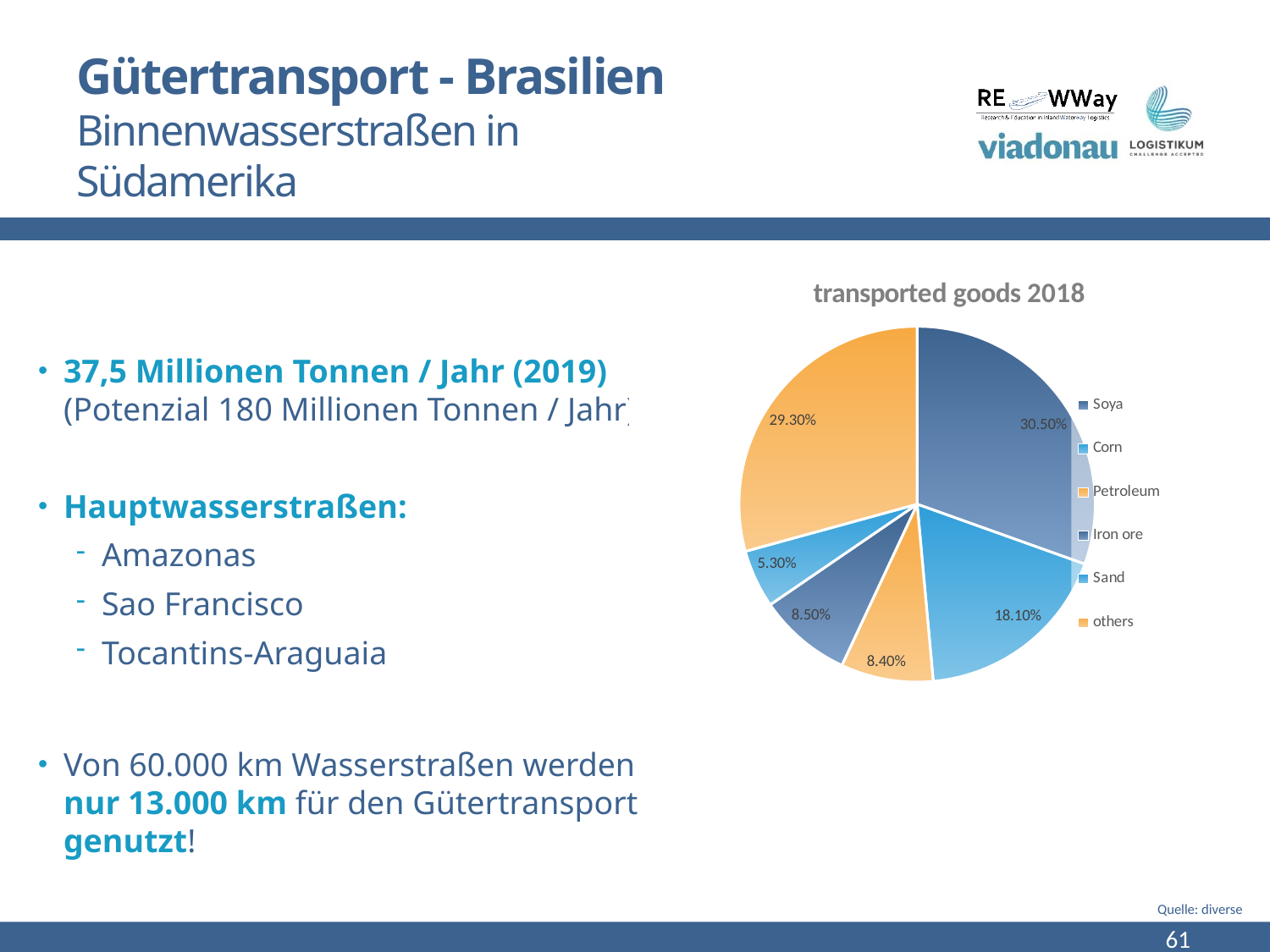
What is the difference between the shares of Soya and others? 1.20% What share of transported goods in 2018 is Iron ore? 8.50% Which has a larger share, Corn or others? others What share of transported goods in 2018 is Soya? 30.50% What share of transported goods in 2018 is Petroleum? 8.40% How many categories does the legend of the pie chart list? 6 What kind of chart is shown on the slide? pie chart What is the title of the chart? transported goods 2018 Which category has the smallest share in the pie chart? Sand What share of transported goods in 2018 is Sand? 5.30% What share of transported goods in 2018 is Corn? 18.10% Which category has the largest share in the pie chart? Soya